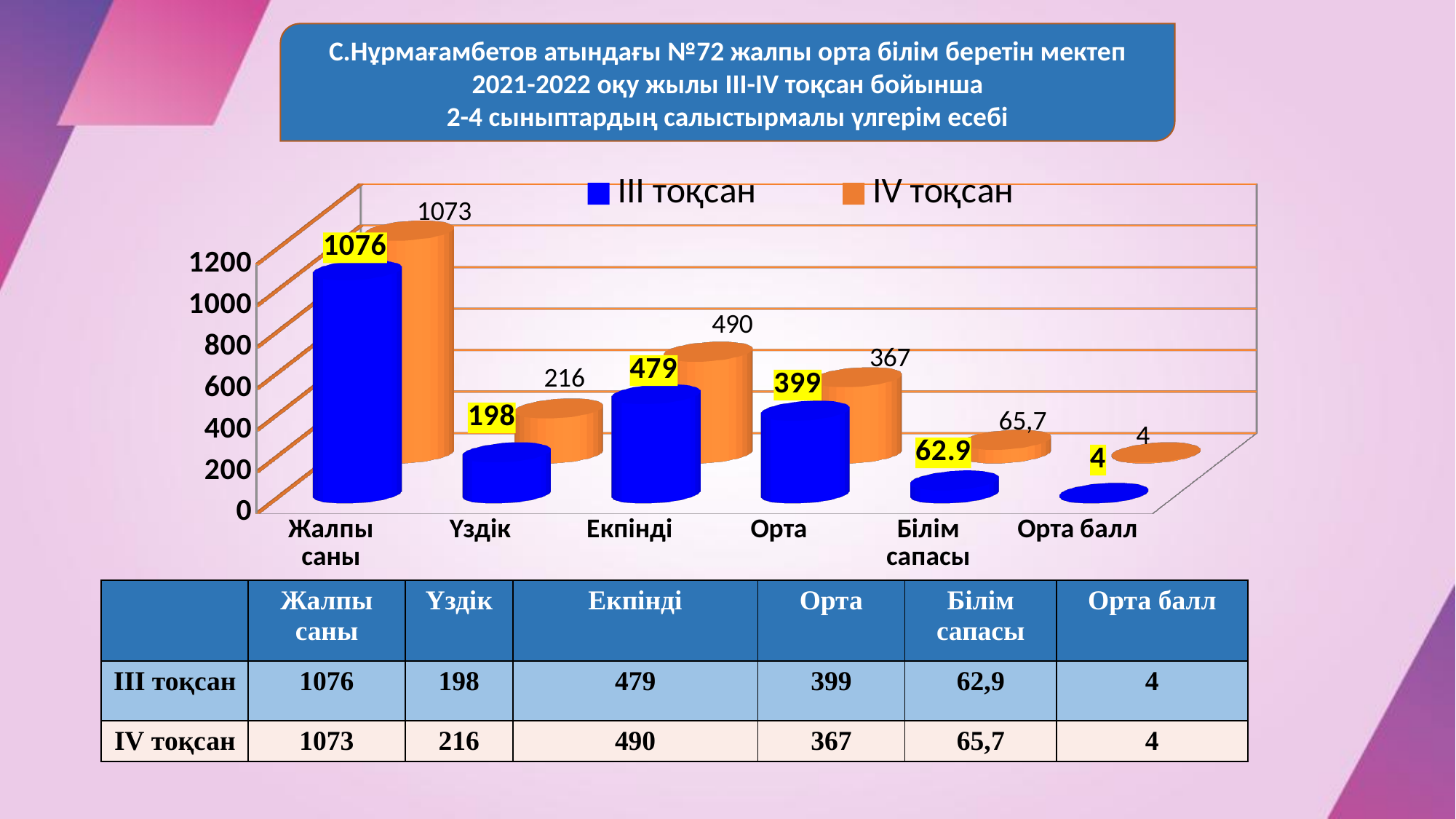
What is the value for Білім сапасы in the IV тоқсан series? 65,7 Which is larger for Екпінді: the III тоқсан value or the IV тоқсан value? IV тоқсан How many categories are shown on the x axis of the chart? 6 What is the value for Екпінді in the IV тоқсан series? 490 What is the difference between the III тоқсан and IV тоқсан values for Орта? 32 What type of chart is shown on the slide? Bar chart What is the value for Үздік in the III тоқсан series? 198 Which category has the highest value in the IV тоқсан series? Жалпы саны How many series does the chart legend list? 2 What is the difference between the IV тоқсан and III тоқсан values for Үздік? 18 What is the value for Жалпы саны in the III тоқсан series? 1076 Which category has the lowest value in the III тоқсан series? Орта балл